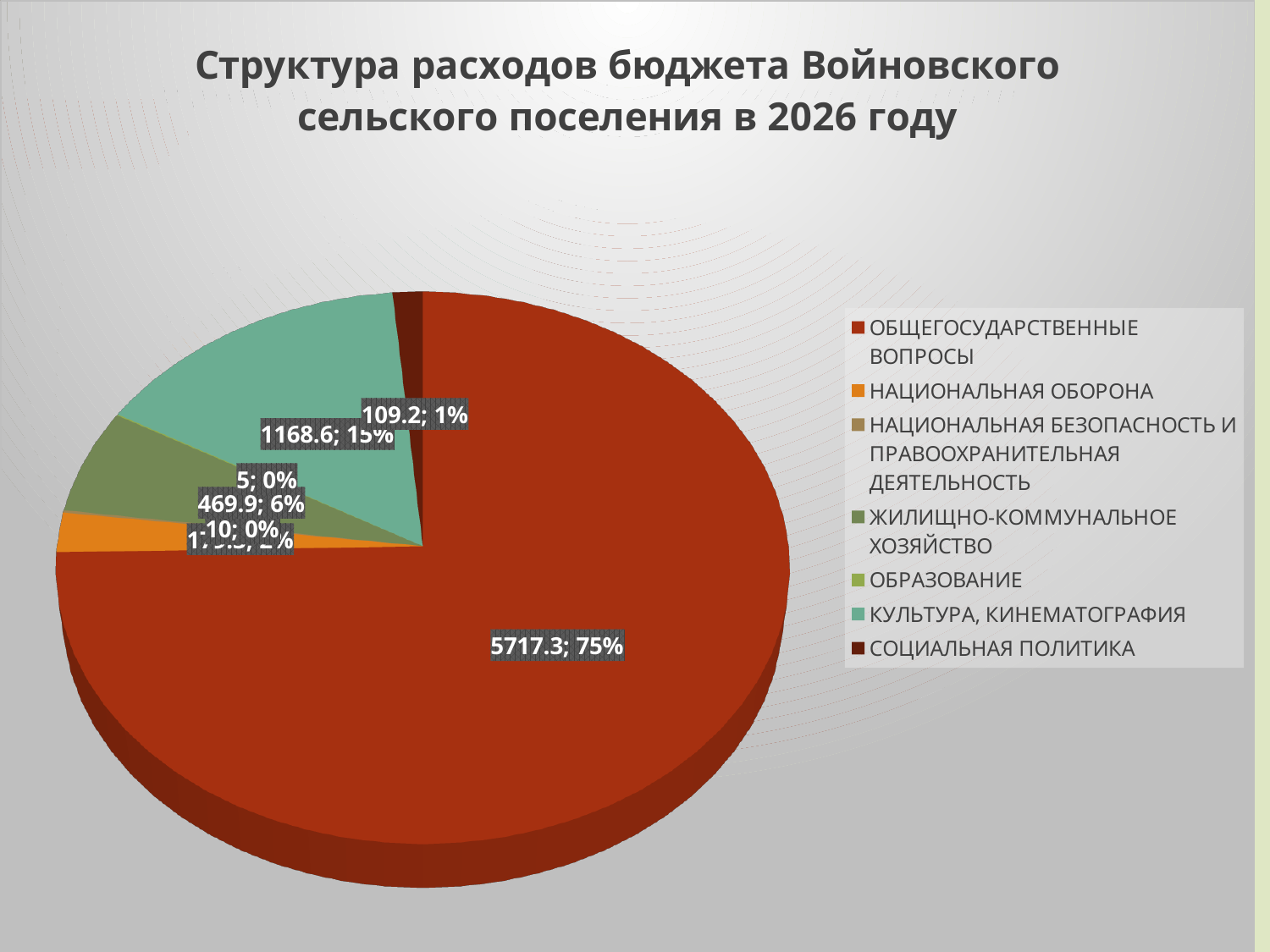
What share of the pie does КУЛЬТУРА, КИНЕМАТОГРАФИЯ take? 15% Which category has the largest slice of the pie chart? ОБЩЕГОСУДАРСТВЕННЫЕ ВОПРОСЫ What is the value shown for ОБЩЕГОСУДАРСТВЕННЫЕ ВОПРОСЫ? 5717.3 What share of the pie does ЖИЛИЩНО-КОММУНАЛЬНОЕ ХОЗЯЙСТВО take? 6% Which is larger, the slice for КУЛЬТУРА, КИНЕМАТОГРАФИЯ or the slice for ЖИЛИЩНО-КОММУНАЛЬНОЕ ХОЗЯЙСТВО? КУЛЬТУРА, КИНЕМАТОГРАФИЯ What kind of chart is shown on the slide? Pie chart What is the value shown for КУЛЬТУРА, КИНЕМАТОГРАФИЯ? 1168.6 What is the value shown for ЖИЛИЩНО-КОММУНАЛЬНОЕ ХОЗЯЙСТВО? 469.9 How many categories does the legend of the pie chart list? 7 What share of the pie does ОБЩЕГОСУДАРСТВЕННЫЕ ВОПРОСЫ take? 75% What is the difference between the values for ОБЩЕГОСУДАРСТВЕННЫЕ ВОПРОСЫ and КУЛЬТУРА, КИНЕМАТОГРАФИЯ? 4548.7 What is the value shown for СОЦИАЛЬНАЯ ПОЛИТИКА? 109.2